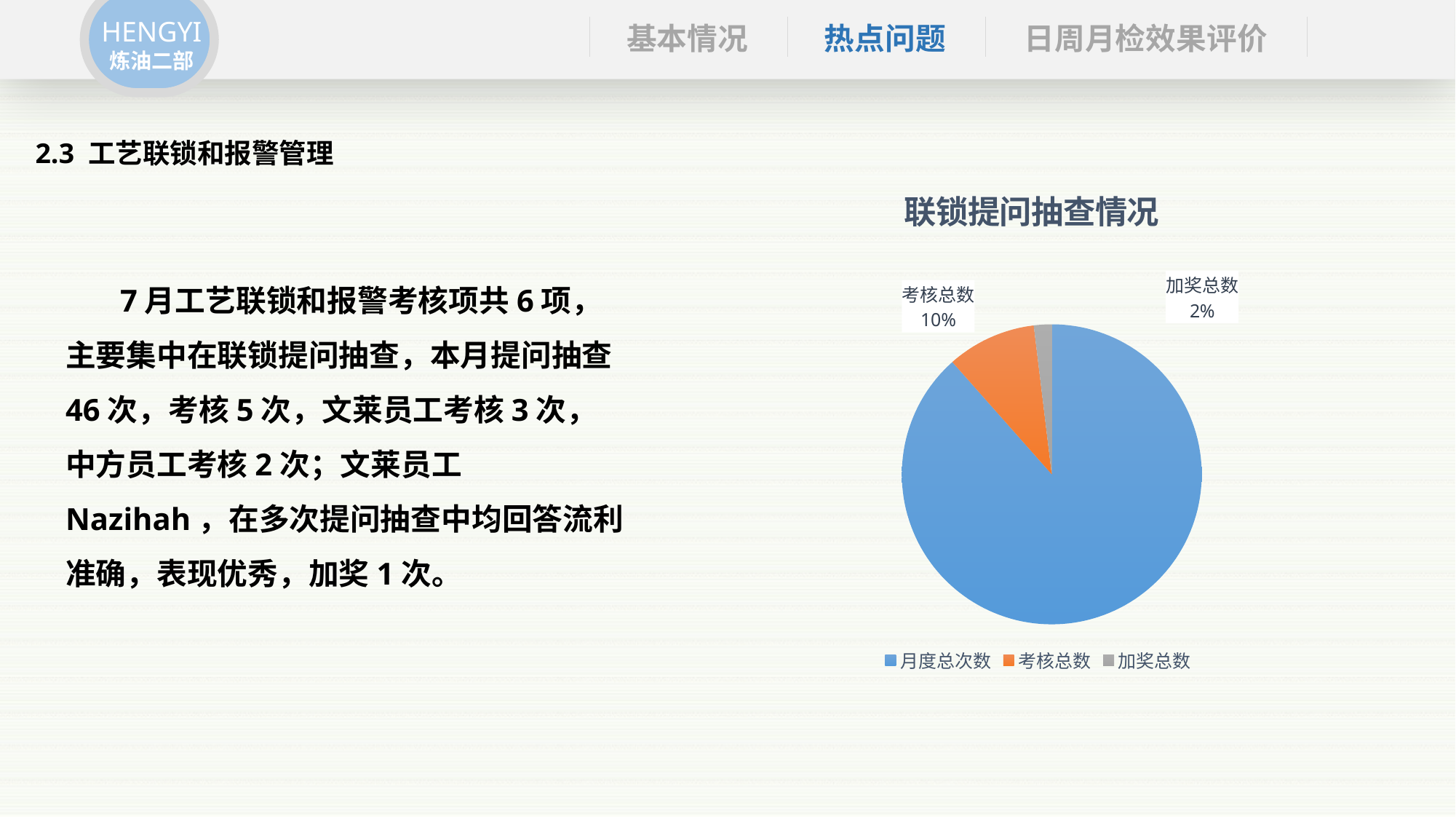
What colour is the 月度总次数 slice in the pie chart? blue What share of the pie does 加奖总数 represent? 2% How many slices does the pie chart have? 3 What share of the pie does 考核总数 represent? 10% How many entries does the chart legend list? 3 Which slice of the pie chart is the smallest? 加奖总数 What is the title of the chart? 联锁提问抽查情况 What kind of chart is shown on the slide? pie chart Which slice of the pie chart is the largest? 月度总次数 Which is larger, the share for 考核总数 or the share for 加奖总数? 考核总数 What is the difference in percentage points between the 考核总数 share and the 加奖总数 share? 8%